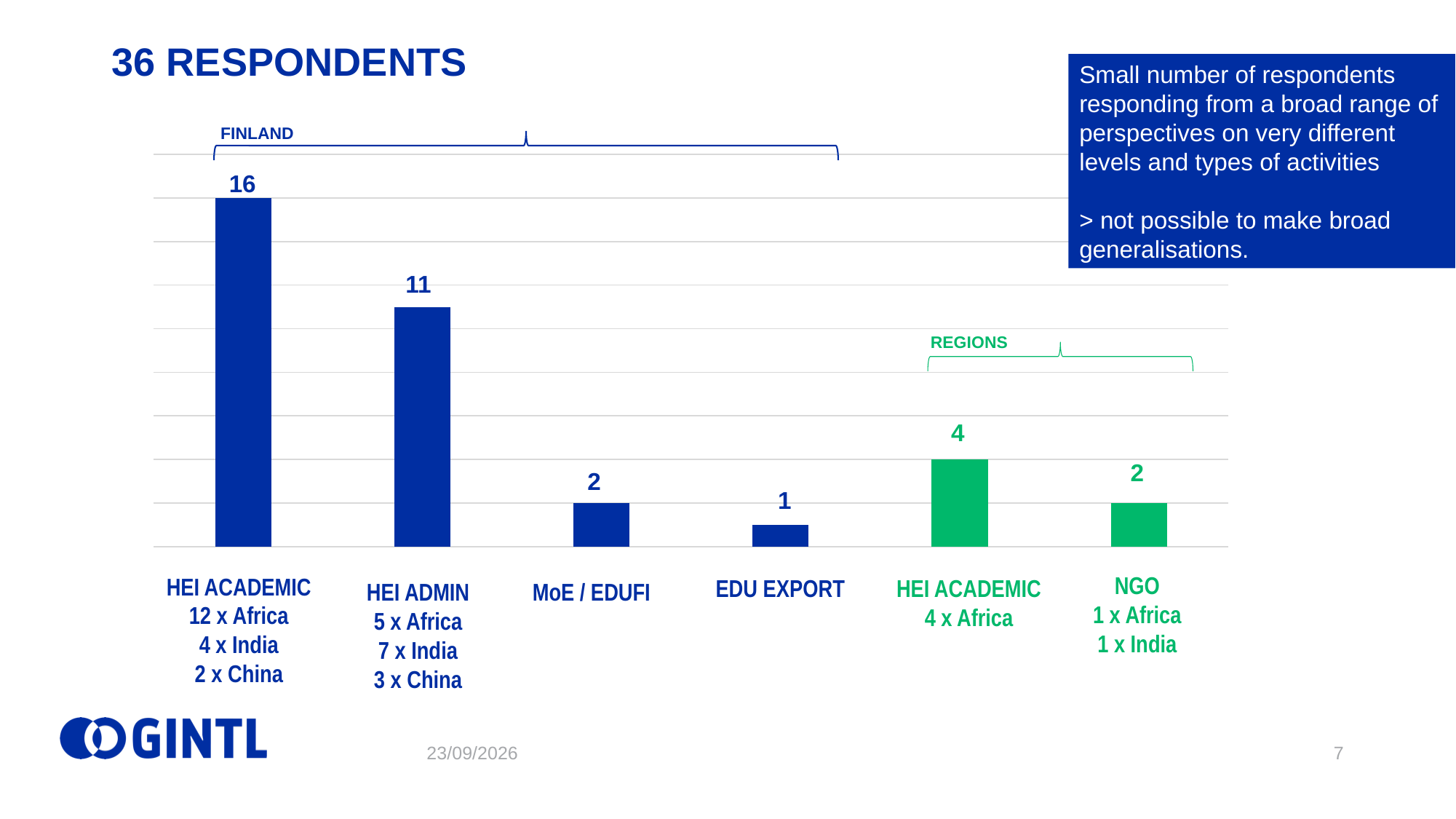
What colour are the bars in the REGIONS group? Green What is the value for HEI ADMIN (Finland)? 11 Which category has the highest value? HEI ACADEMIC (Finland) Which is larger, the value for Regions HEI ACADEMIC or the value for NGO? Regions HEI ACADEMIC What kind of chart is shown on the slide? Bar chart What is the value for EDU EXPORT? 1 Which category has the lowest value? EDU EXPORT What is the value for NGO (Regions)? 2 How many bars are shown in the chart? 6 What is the difference between the Finland HEI ACADEMIC value and the Regions HEI ACADEMIC value? 12 What is the difference between the Finland HEI ACADEMIC value and the Finland HEI ADMIN value? 5 What is the value for MoE / EDUFI? 2